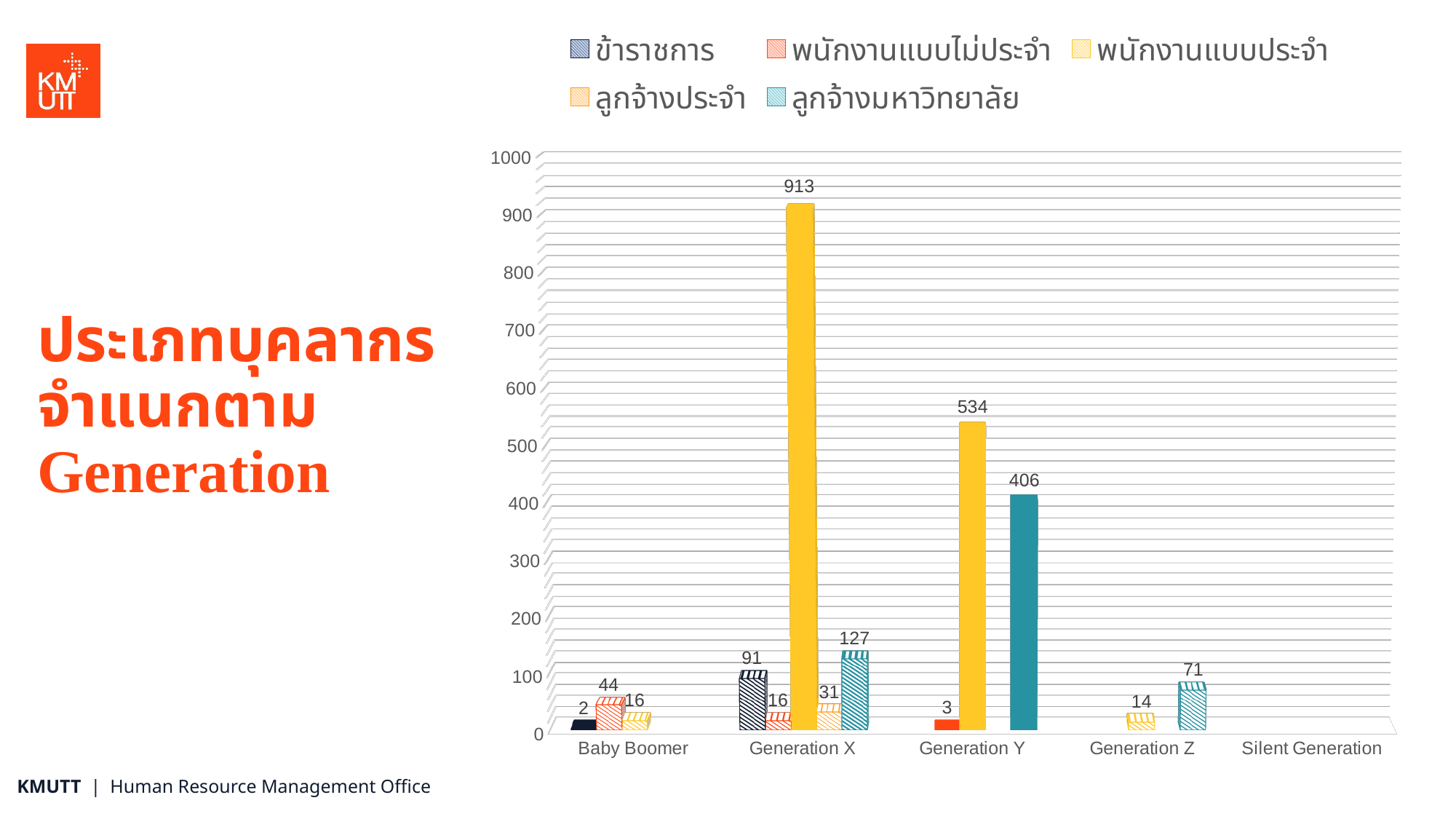
How many generation categories are shown on the x axis? 5 What is the value for ข้าราชการ in Generation X? 91 What is the value for พนักงานแบบประจำ in Generation X? 913 Which is larger in Generation Y: พนักงานแบบประจำ or ลูกจ้างมหาวิทยาลัย? พนักงานแบบประจำ Which category on the x axis has no bars plotted? Silent Generation What is the difference between พนักงานแบบประจำ in Generation X and in Generation Y? 379 What is the value for ลูกจ้างมหาวิทยาลัย in Generation Y? 406 What type of chart is shown on the slide? bar chart Which generation has the highest value for พนักงานแบบประจำ? Generation X What is the value for พนักงานแบบไม่ประจำ in Baby Boomer? 44 How many series does the legend list? 5 Which generation has the lowest value for ลูกจ้างมหาวิทยาลัย among those with a bar? Generation Z